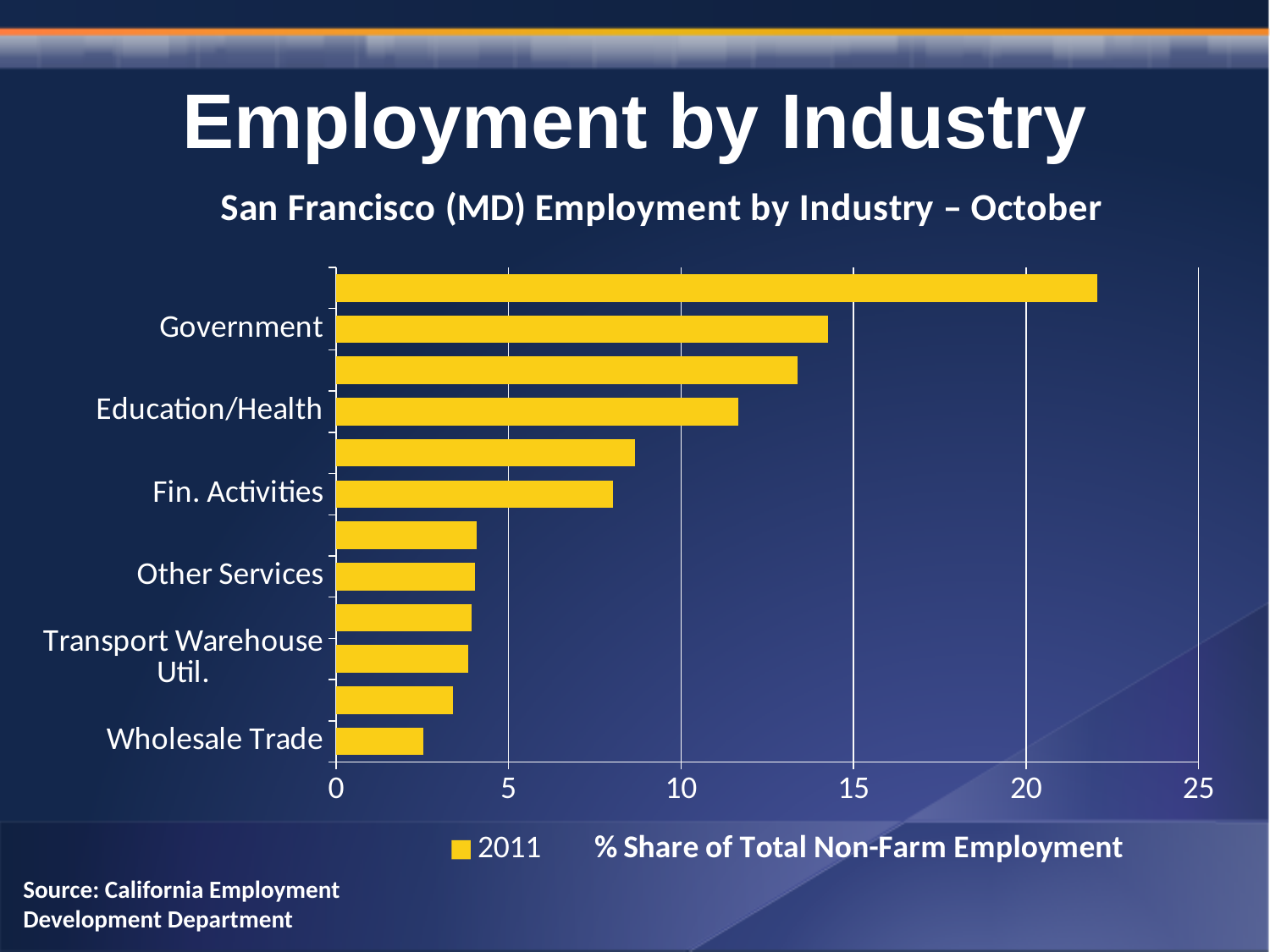
How many bars are plotted in the chart? 12 Which has the larger value, Government or Education/Health? Government Is the value for Government greater or less than 10? greater What is the legend entry for the series in the chart? 2011 Is the value for Government greater or less than 15? less Is the value for Education/Health greater or less than 10? greater How many series does the legend list? 1 What is the x-axis title of the chart? % Share of Total Non-Farm Employment What kind of chart is shown on the slide? bar chart Which of the labelled categories has the lowest value? Wholesale Trade